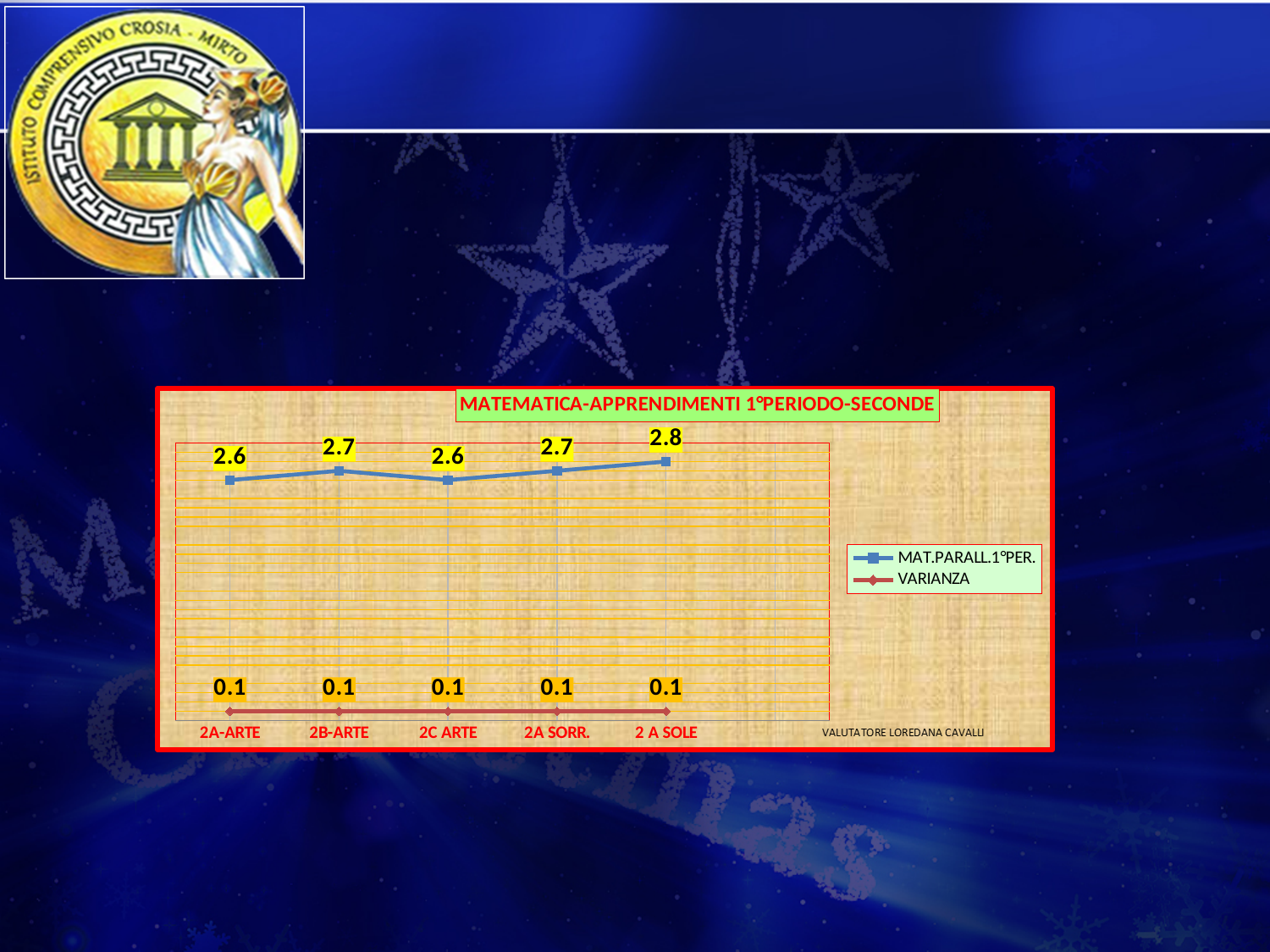
Which category has the highest MAT.PARALL.1°PER. value? 2 A SOLE How many categories are shown on the x axis? 5 What is the MAT.PARALL.1°PER. value for 2A-ARTE? 2.6 What is the VARIANZA value for 2A SORR.? 0.1 What type of chart is shown on the slide? line chart How many series does the legend list? 2 Which series is drawn in blue? MAT.PARALL.1°PER. Which has a larger MAT.PARALL.1°PER. value, 2B-ARTE or 2C ARTE? 2B-ARTE What is the MAT.PARALL.1°PER. value for 2 A SOLE? 2.8 What is the MAT.PARALL.1°PER. value for 2B-ARTE? 2.7 What is the difference between the MAT.PARALL.1°PER. values for 2 A SOLE and 2C ARTE? 0.2 What is the title of the chart? MATEMATICA-APPRENDIMENTI 1°PERIODO-SECONDE